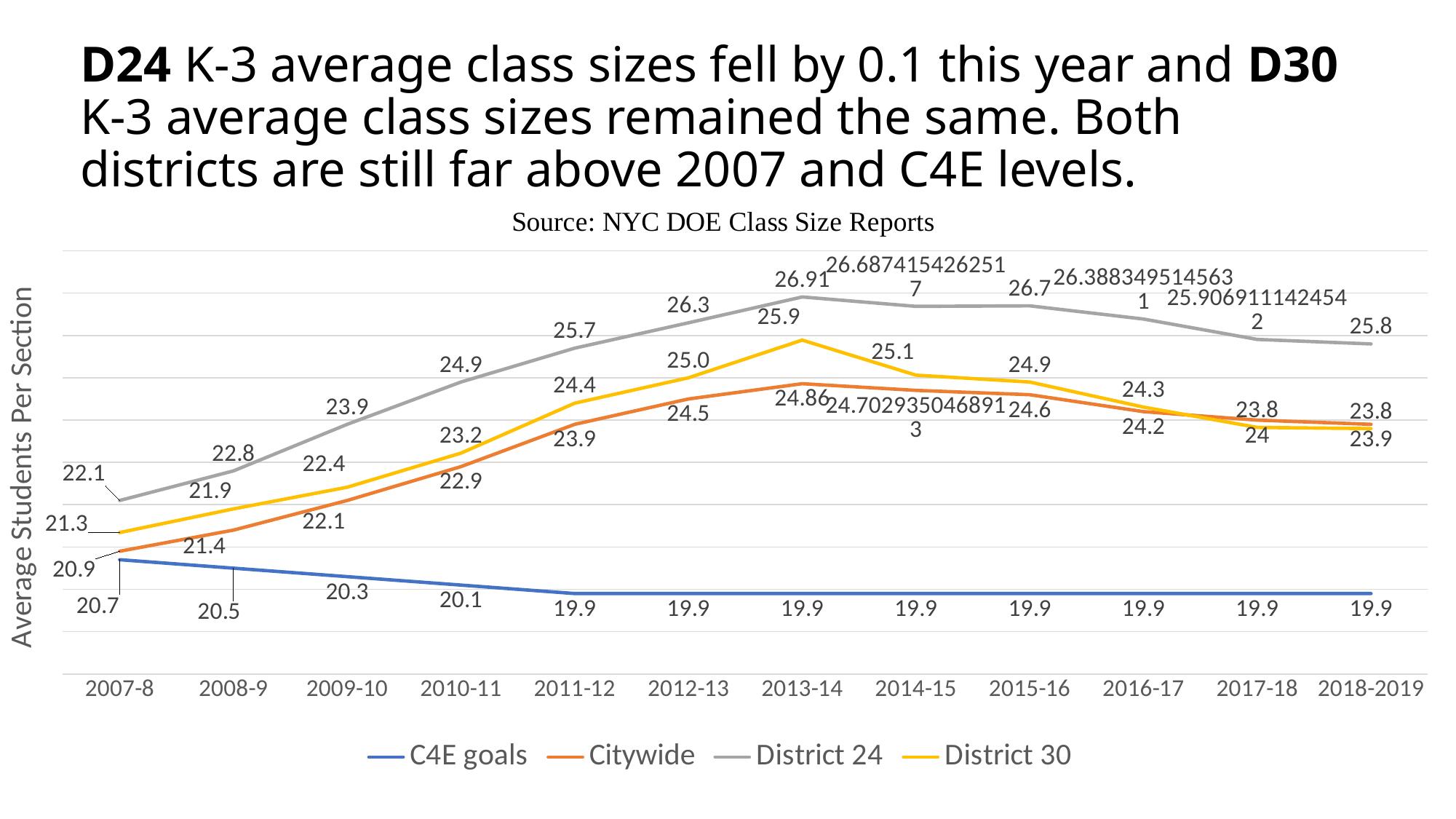
What is the difference between the District 24 value in 2018-2019 and in 2007-8? 3.7 In which school year is the District 24 value highest? 2013-14 In which school year is the District 30 value lowest? 2007-8 How many series does the legend list? 4 What is the Citywide value for 2018-2019? 23.9 How many school years are shown on the x axis? 12 What kind of chart is shown on the slide? line chart What is the District 24 value for 2012-13? 26.3 What is the title of the y axis? Average Students Per Section What is the C4E goals value for 2007-8? 20.7 Which is larger in 2011-12, the District 24 value or the District 30 value? District 24 What is the District 30 value for 2013-14? 25.9